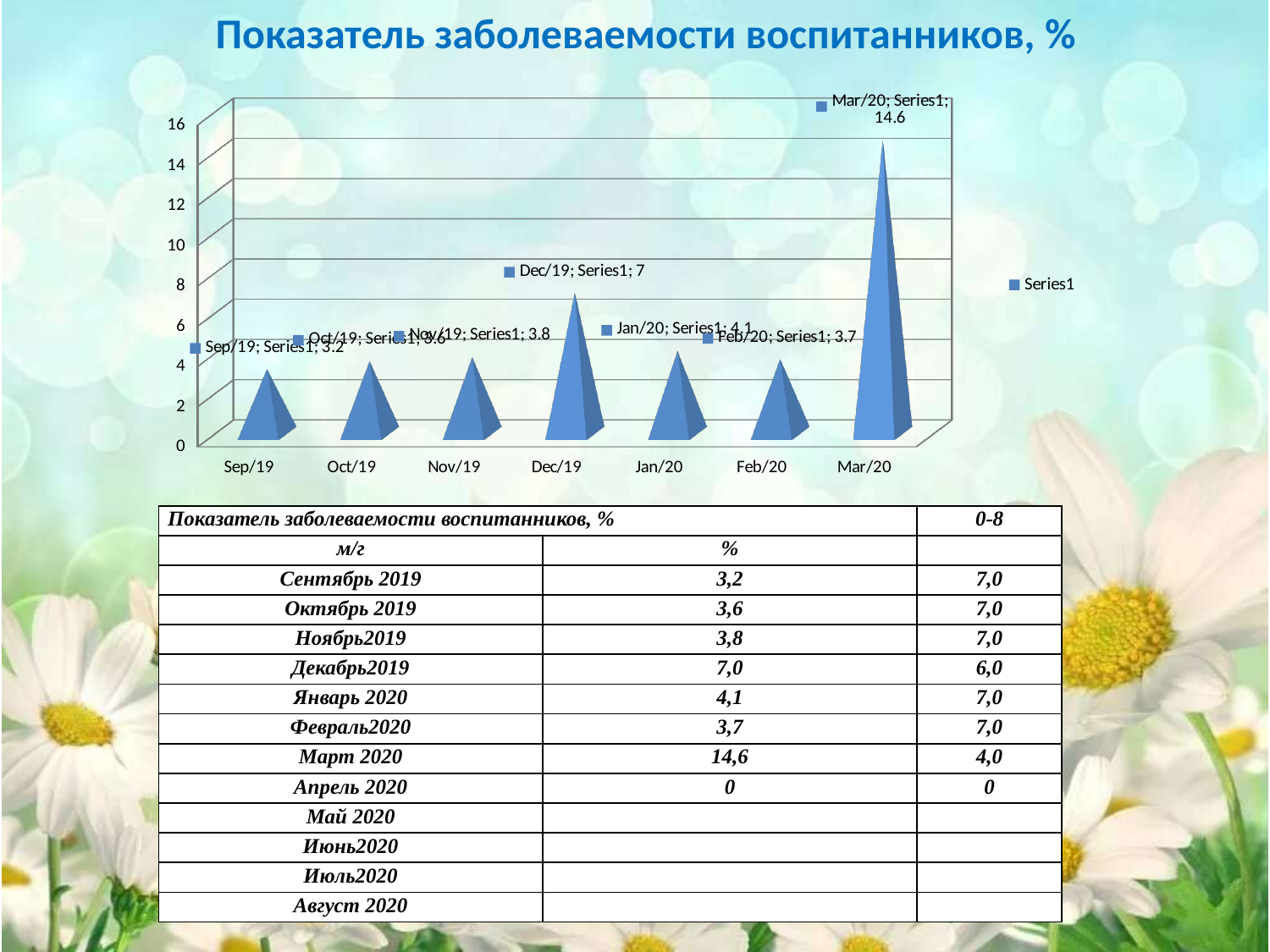
How many months are shown on the x axis of the chart? 7 Which is larger, the value for Dec/19 or the value for Jan/20? Dec/19 Which month has the highest value? Mar/20 What is the value for Sep/19? 3.2 What is the value for Mar/20? 14.6 What kind of chart is shown on the slide? bar chart What is the value for Jan/20? 4.1 Is the value for Mar/20 greater or less than 10? greater What is the value for Dec/19? 7 What is the difference between the values for Mar/20 and Dec/19? 7.6 What is the value for Feb/20? 3.7 Which month has the lowest value? Sep/19